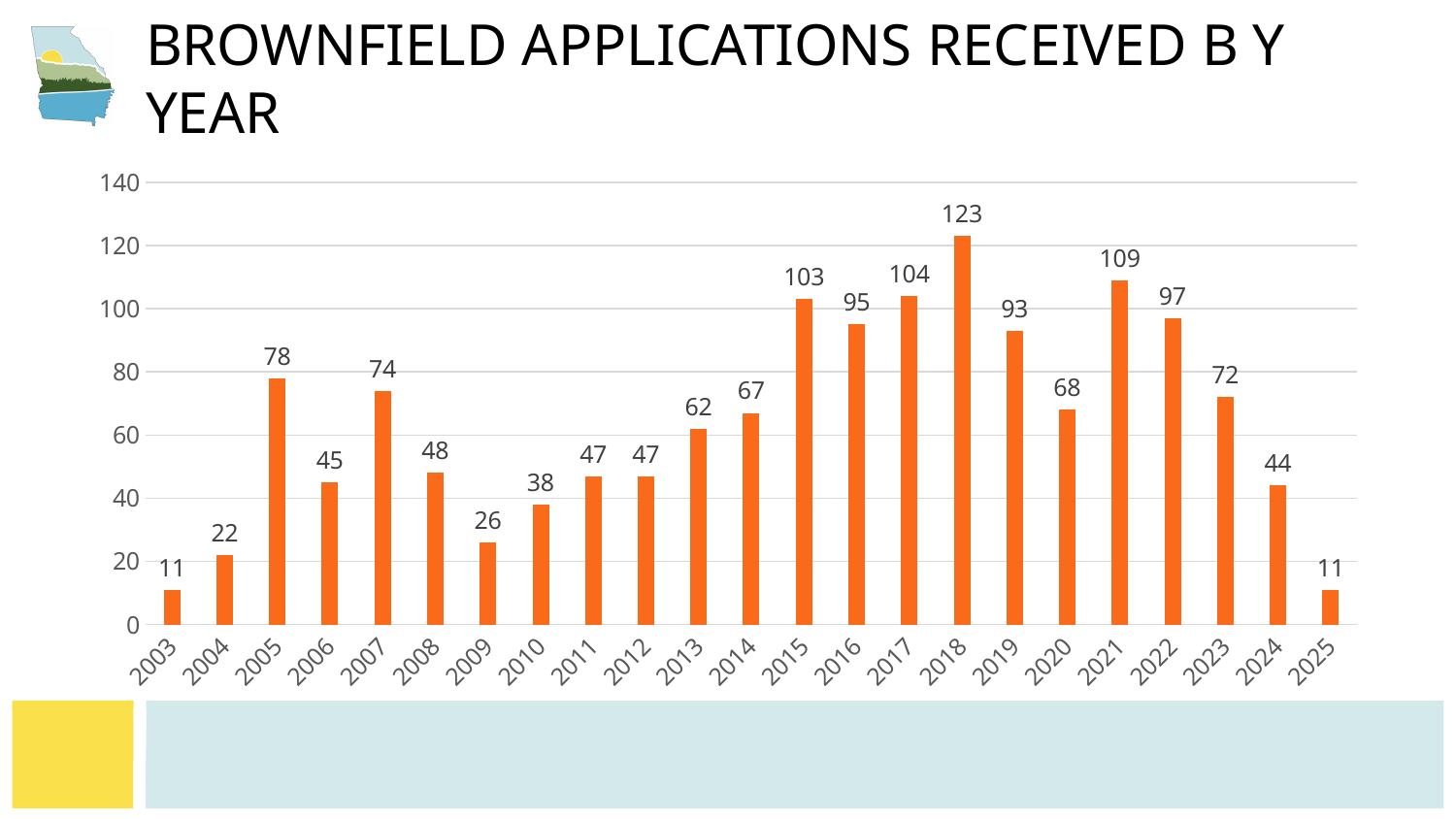
What is the title of the chart? BROWNFIELD APPLICATIONS RECEIVED BY YEAR What kind of chart is shown on the slide? bar chart How many brownfield applications were received in 2018? 123 Is the value for 2015 greater or less than 100? greater What is the value shown for 2009? 26 What colour are the bars in the chart? orange Do the values rise or fall from 2021 to 2025? fall Which year has the highest number of brownfield applications received? 2018 How many years are shown on the x axis? 23 Which years share the lowest value on the chart? 2003 and 2025 What is the difference between the values for 2021 and 2020? 41 Which year has a larger value, 2005 or 2007? 2005